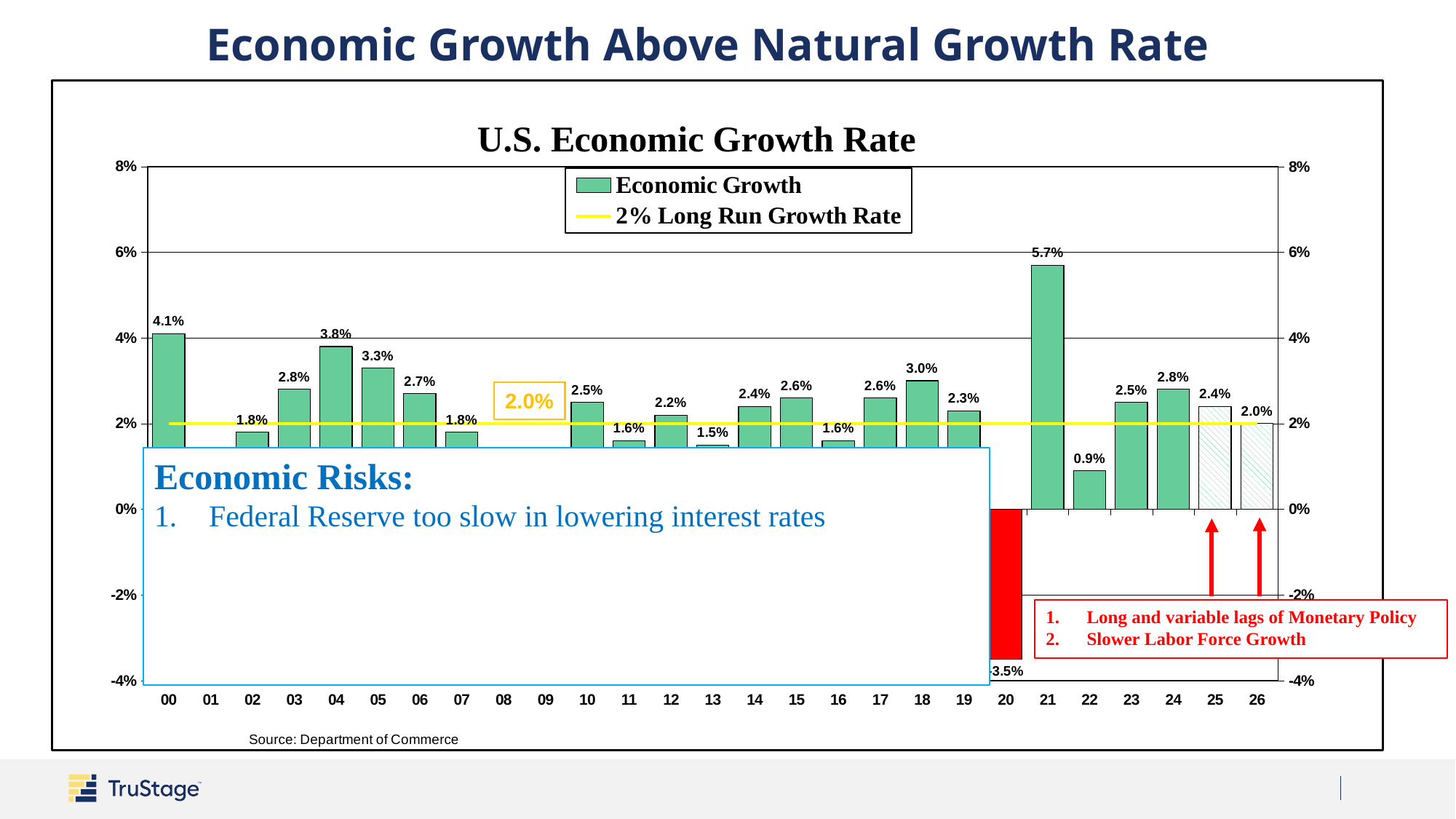
What does the yellow horizontal line represent according to the legend? 2% Long Run Growth Rate What kind of chart is used to show the economic growth values? bar chart How many series does the legend list? 2 Which year has the highest economic growth rate? 21 Which year has the lowest economic growth rate? 20 What is the difference between the growth rates for 21 and 22? 4.8 percentage points Which year has the higher growth rate, 18 or 19? 18 What is the economic growth rate shown for 26? 2.0% What is the economic growth rate shown for 21? 5.7% Is the growth rate for 22 greater or less than 2%? less What is the difference between the growth rates for 00 and 02? 2.3 percentage points What is the economic growth rate shown for 04? 3.8%